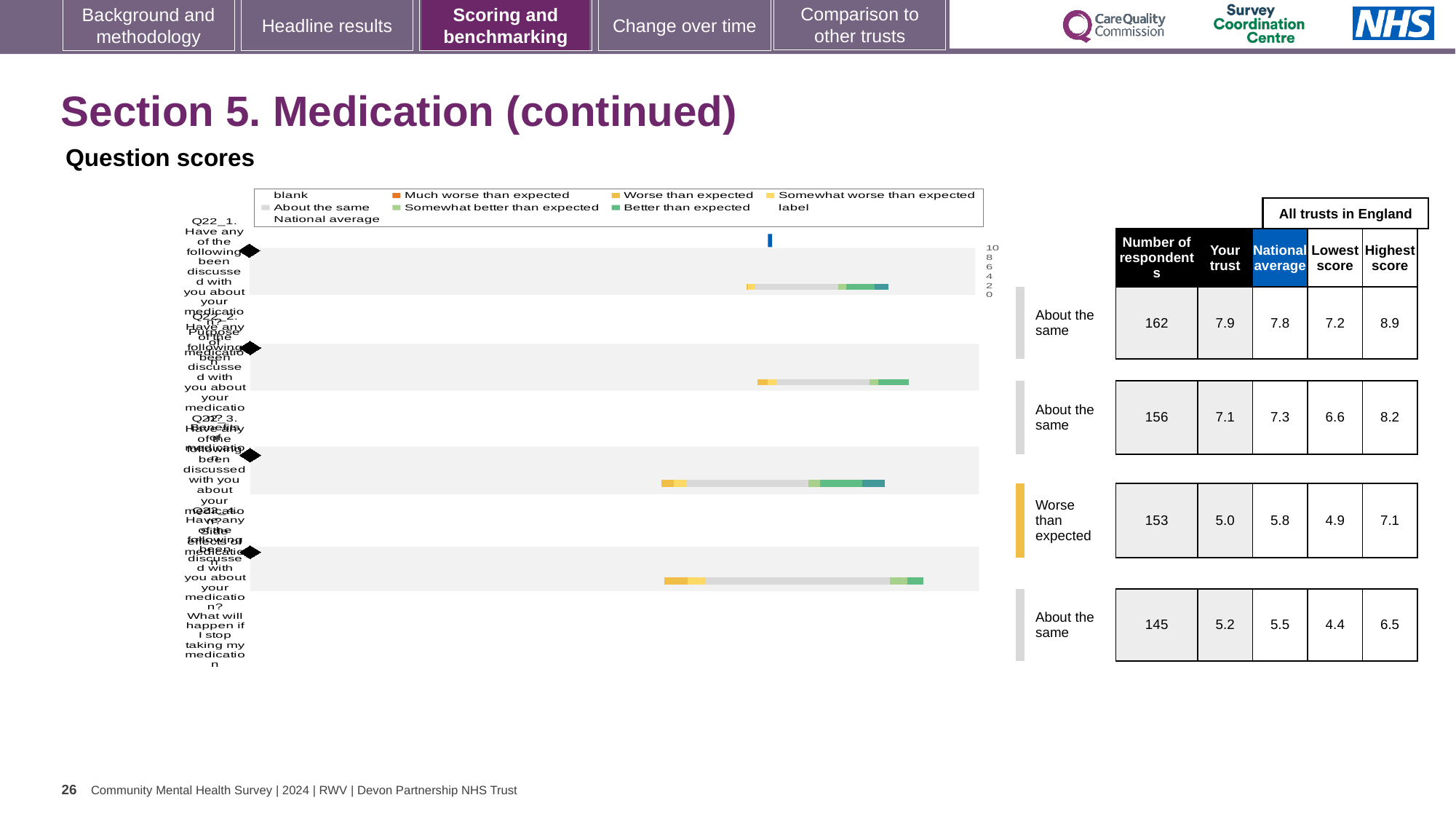
In the table beside the chart, what is the national average for the third question (Q22_3)? 5.8 What is the difference between the highest score (8.9) and the lowest score (7.2) for the first question in the table beside the chart? 1.7 What kind of chart is used to show the question scores on this slide? bar chart Which legend entry in the chart is shown in dark orange? Much worse than expected How many question bars are plotted in the question scores chart? 4 For the second question (Q22_2), is the 'Your trust' score (7.1) or the national average (7.3) larger? National average In the table beside the chart, how many respondents answered the fourth question (Q22_4, what will happen if I stop taking my medication)? 145 What is the highest value shown on the chart's axis scale? 10 Which question is rated 'Worse than expected' in the benchmarking labels next to the chart? Q22_3 (the third question) Which of the four questions has the highest 'Your trust' score in the table beside the chart? Q22_1 (7.9) Which of the four questions has the lowest 'Your trust' score in the table beside the chart? Q22_3 (5.0) In the table beside the chart, what is the 'Your trust' score for the first question (Q22_1)? 7.9